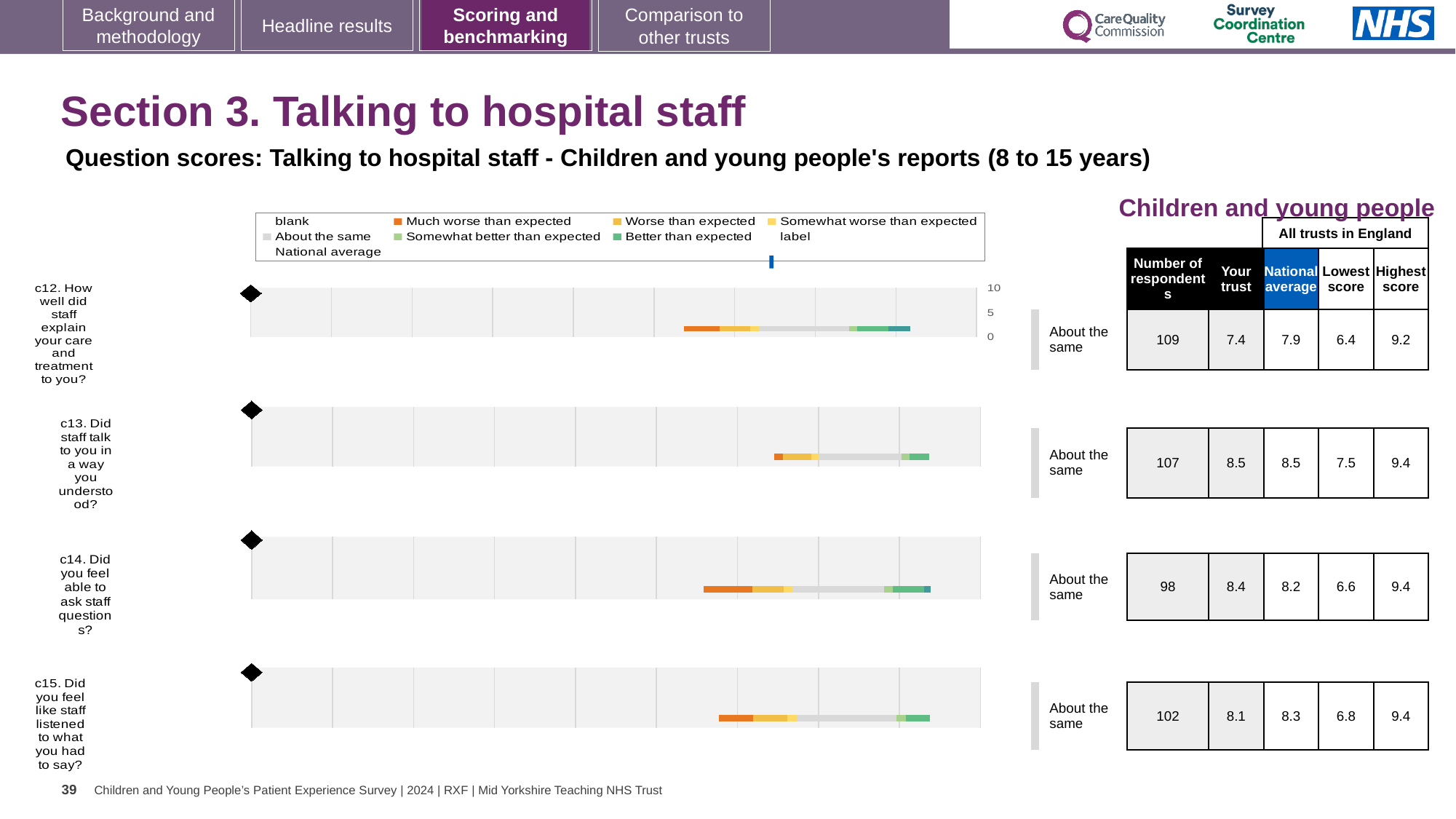
What is the highest tick value shown on the axis of the c12 chart? 10 For the c14 chart, what is the difference between the 'Your trust' score and the national average? 0.2 How many question charts (c12 to c15) are shown on the slide? 4 For the c13 chart (Did staff talk to you in a way you understood?), what is the national average shown in the table? 8.5 Which of the four questions (c12 to c15) has the highest 'Your trust' score? c13 For the c14 chart (Did you feel able to ask staff questions?), what is the number of respondents? 98 What kind of chart is used for question c12 on the slide? bar chart Which of the four questions (c12 to c15) has the lowest 'Your trust' score? c12 How many entries does the shared legend above the charts list? 9 Which legend entry is shown in orange? Much worse than expected For the c15 chart (Did you feel like staff listened to what you had to say?), what is the lowest score across all trusts in England? 6.8 For the c12 chart (How well did staff explain your care and treatment to you?), what is the 'Your trust' score shown in the table? 7.4